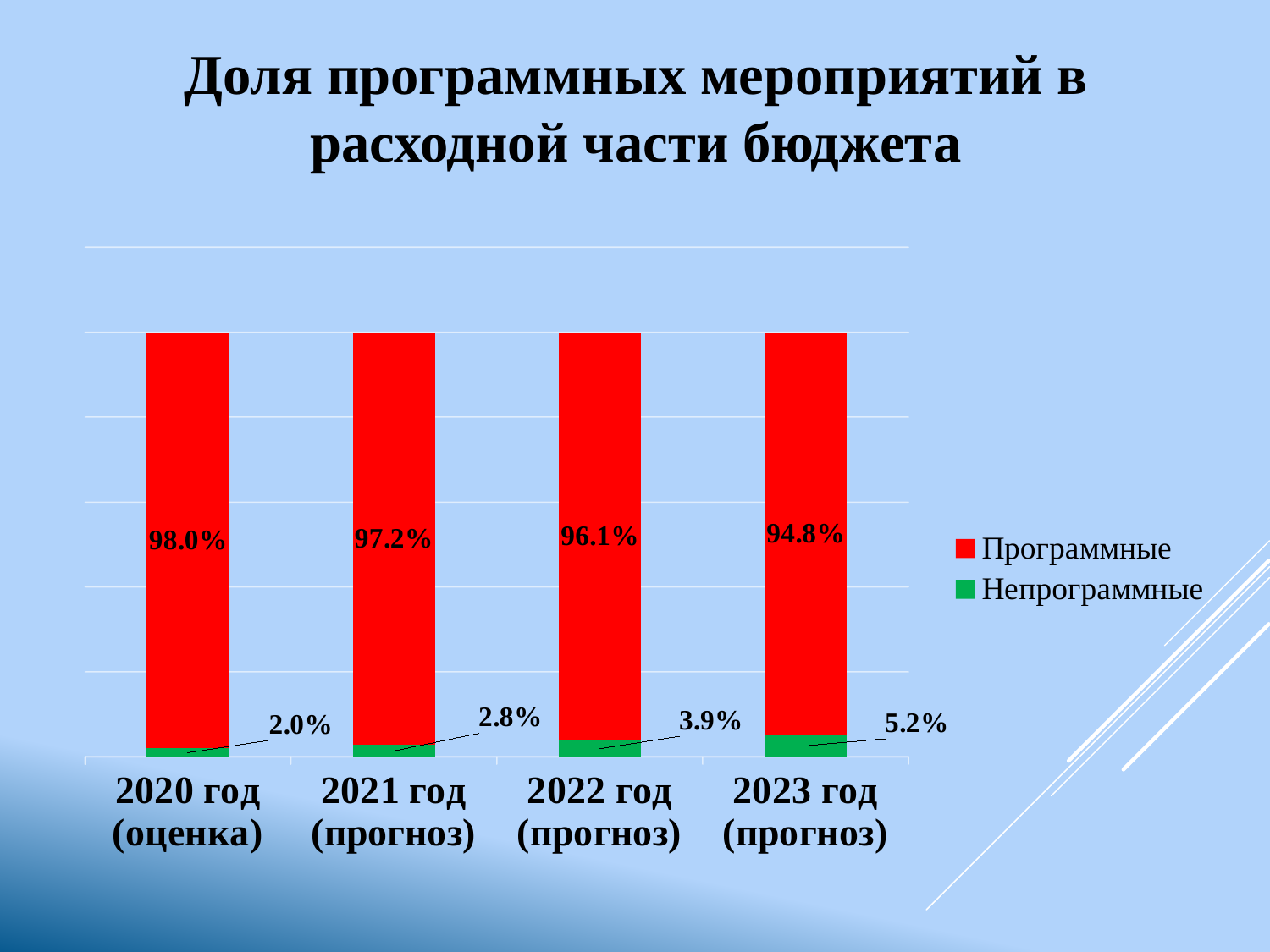
What is the value for Непрограммные in 2023 год (прогноз)? 5.2% In which year is the Непрограммные share the highest? 2023 год (прогноз) How many year categories are shown on the x axis? 4 What is the value for Программные in 2020 год (оценка)? 98.0% What is the value for Непрограммные in 2021 год (прогноз)? 2.8% In which year is the Программные share the lowest? 2023 год (прогноз) What is the value for Программные in 2022 год (прогноз)? 96.1% What is the difference between the Программные value in 2020 год (оценка) and in 2023 год (прогноз)? 3.2 percentage points Does the Непрограммные share rise or fall from 2020 to 2023? Rises What kind of chart is shown on the slide? Stacked bar chart How many series does the legend list? 2 Which is larger: the Непрограммные value in 2022 год (прогноз) or in 2021 год (прогноз)? 2022 год (прогноз)